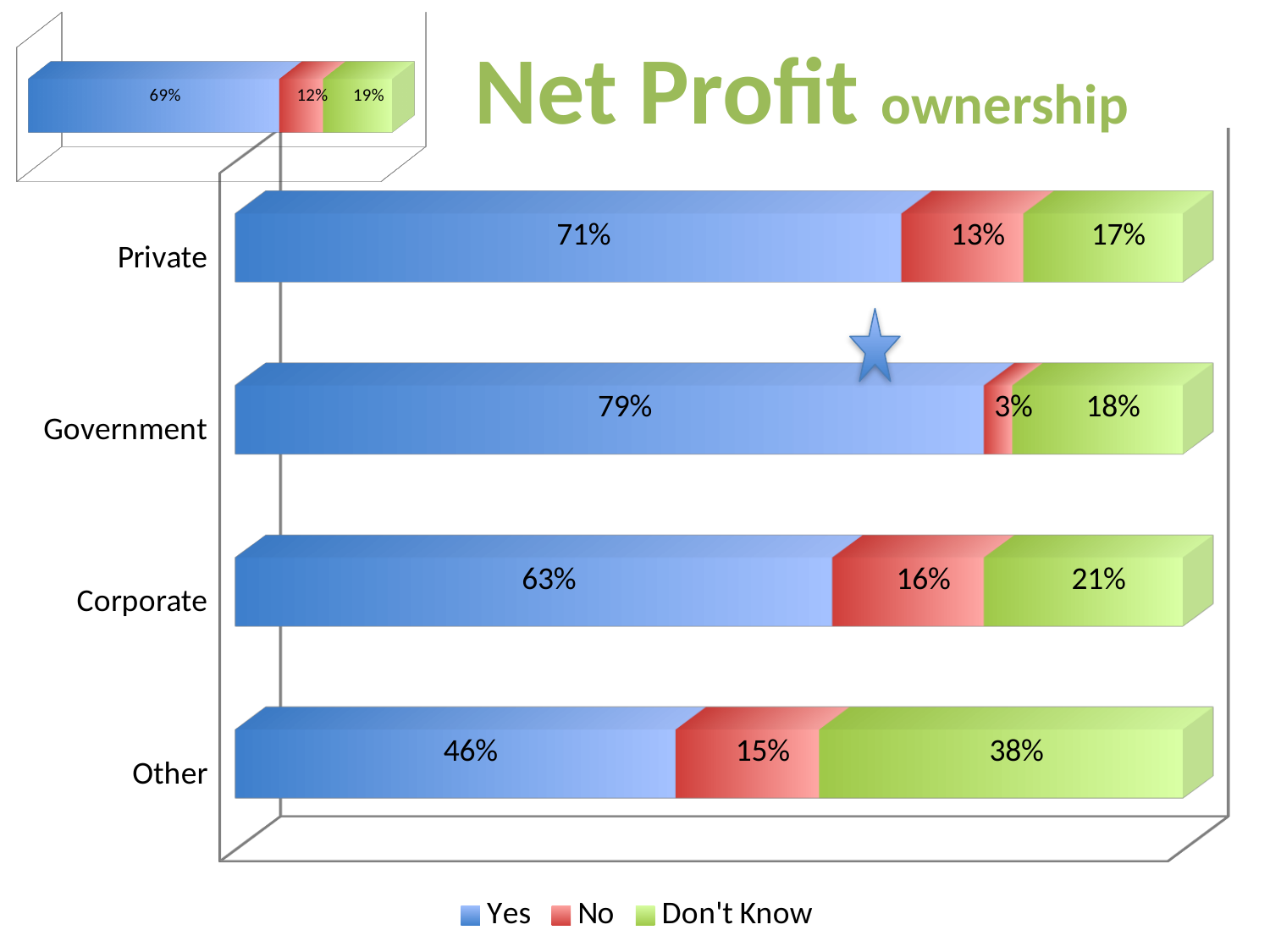
How many categories does the main chart show? 4 In the main chart, what is the Don't Know value for Other? 38% In the main chart, which is larger: the Don't Know value for Corporate or the Don't Know value for Private? Corporate What is the title of the slide's main chart? Net Profit ownership In the main chart, which category has the highest Yes value? Government What kind of chart is the main chart? Stacked bar chart In the main chart, what is the difference between the Yes values for Private and Corporate? 8% In the main chart, what is the No value for Corporate? 16% In the main chart, which category has the lowest No value? Government In the main chart, what is the Yes value for Government? 79% In the small chart in the top-left corner, what is the value of the blue segment? 69% How many series does the legend of the main chart list? 3